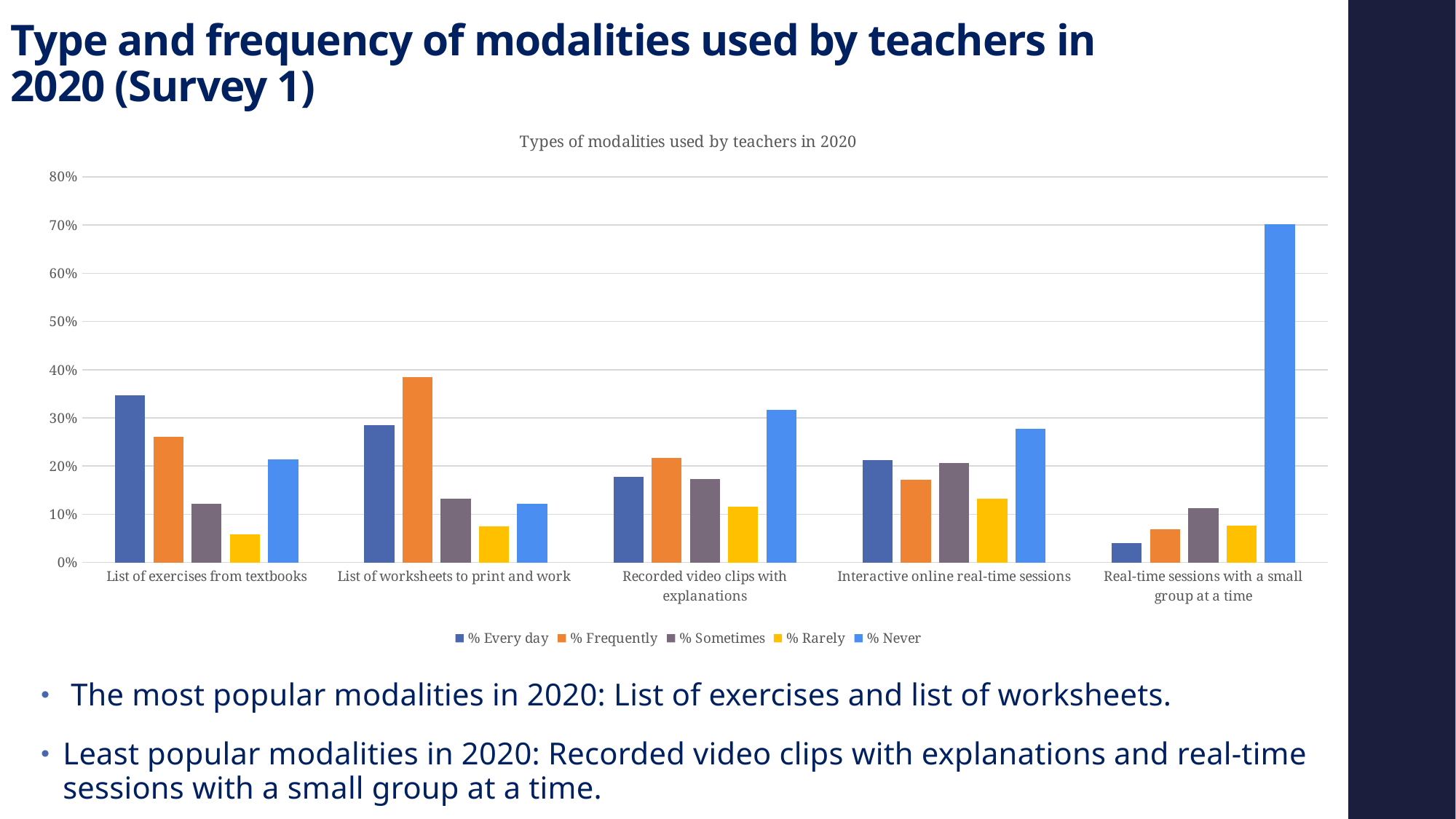
What kind of chart is shown on the slide? Bar chart Which modality has the highest % Never value? Real-time sessions with a small group at a time Which modality has the lowest % Every day value? Real-time sessions with a small group at a time Is the % Every day value for List of exercises from textbooks greater or less than 30%? greater Is the % Rarely value for List of exercises from textbooks greater or less than 10%? less How many series does the legend list? 5 Which modality has the highest % Every day value? List of exercises from textbooks Is the % Frequently value for List of worksheets to print and work greater or less than 30%? greater What is the title of the chart? Types of modalities used by teachers in 2020 For List of worksheets to print and work, which is larger: % Every day or % Frequently? % Frequently How many modality categories are shown on the x axis? 5